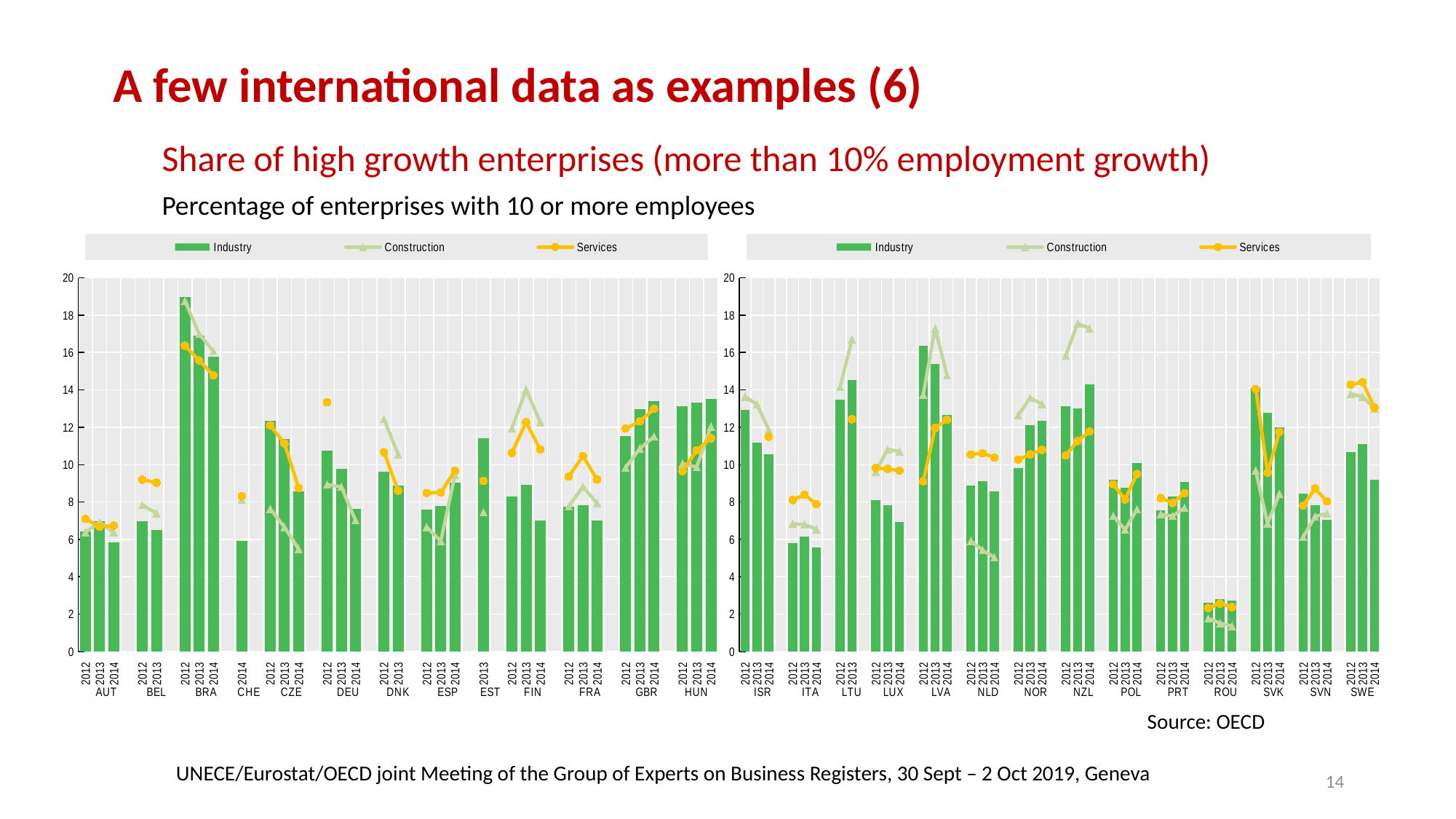
In the left chart, is the Services value for DEU 2012 greater or less than 12? greater In the left chart, what are the three series named in the legend? Industry, Construction, Services In the left chart, how many series does the legend list? 3 In the left chart, do the Industry bars for BRA rise or fall from 2012 to 2014? fall In the left chart, how many countries are shown on the x axis? 13 In the right chart, is the Industry value for ROU 2012 greater or less than 4? less In the left chart, which is larger for DEU 2012: the Industry bar or the Services point? Services In the left chart, which country and year has the highest Industry bar? BRA 2012 In the right chart, how many countries are shown on the x axis? 14 In the left chart, is the Industry value for BRA 2012 greater or less than 18? greater In the right chart, which country has the lowest Industry bars? ROU In the right chart, which country and year has the highest Industry bar? LVA 2012